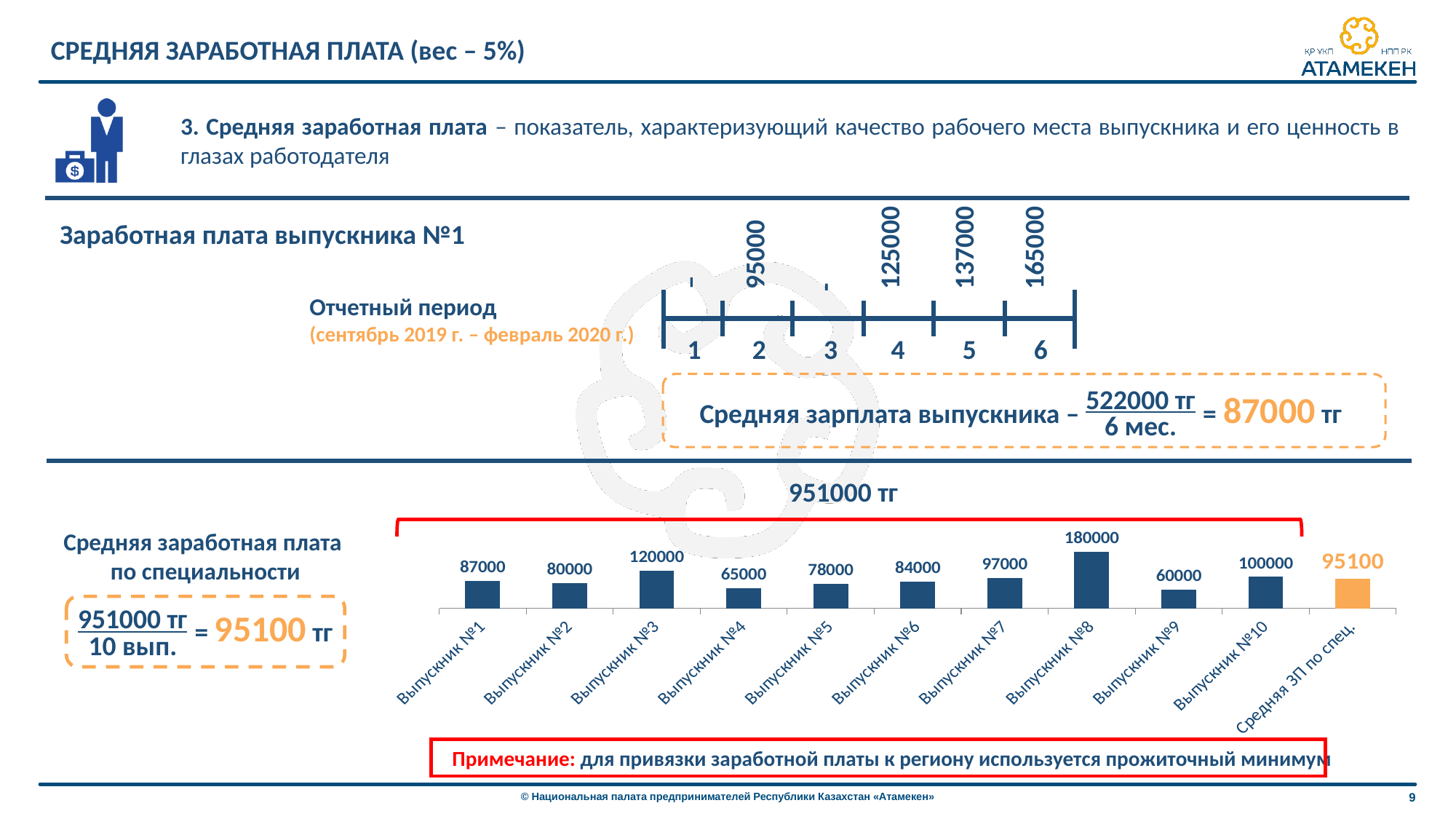
In the bar chart, what is the difference between the values for Выпускник №10 and Выпускник №1? 13000 In the bar chart, which is larger: the value for Выпускник №2 or Выпускник №6? Выпускник №6 In the bar chart, what is the value for Средняя ЗП по спец.? 95100 How many bars are shown in the bar chart? 11 In the bar chart, what is the value for Выпускник №9? 60000 In the bar chart, which category has the highest value? Выпускник №8 In the bar chart, what is the difference between the values for Выпускник №8 and Выпускник №9? 120000 What kind of chart is shown at the bottom of the slide? bar chart In the bar chart, which category has the lowest value? Выпускник №9 In the bar chart, what colour is the bar for Средняя ЗП по спец.? orange In the bar chart, what is the value for Выпускник №3? 120000 In the bar chart, which is larger: the value for Выпускник №4 or Выпускник №5? Выпускник №5